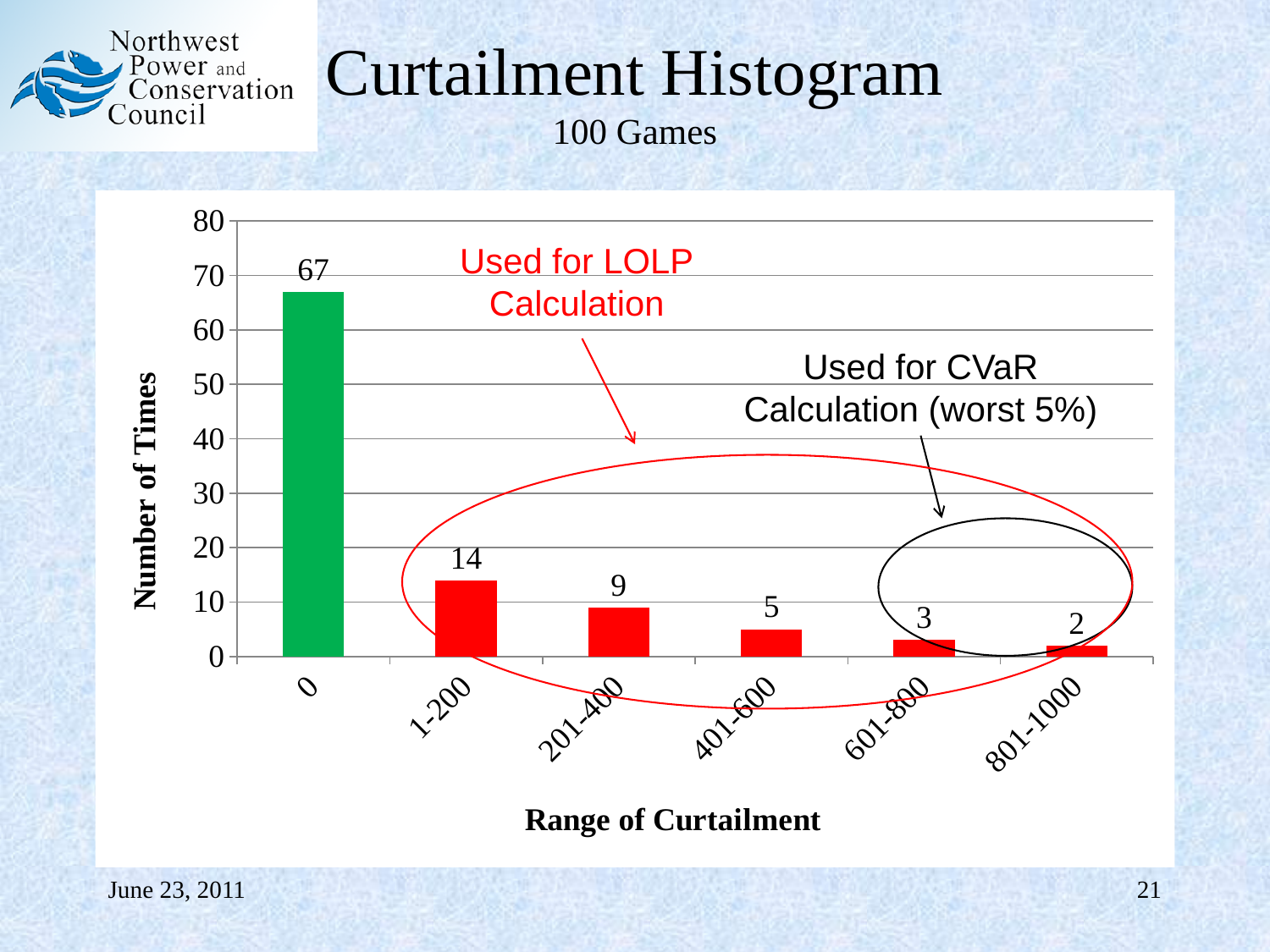
Which range of curtailment has the lowest number of times? 801-1000 What is the number of times for the curtailment range 1-200? 14 How many ranges of curtailment are shown on the x axis? 6 What is the label of the y axis? Number of Times What kind of chart is shown on the slide? bar chart What is the number of times for the curtailment range 401-600? 5 Which range of curtailment has the highest number of times? 0 What is the difference in number of times between the 1-200 range and the 201-400 range? 5 Is the number of times for the 0 range greater or less than 60? greater Do the number of times values rise or fall moving from the 1-200 range to the 801-1000 range? fall Which has a higher number of times, the 601-800 range or the 801-1000 range? 601-800 What is the number of times for the curtailment range 0? 67